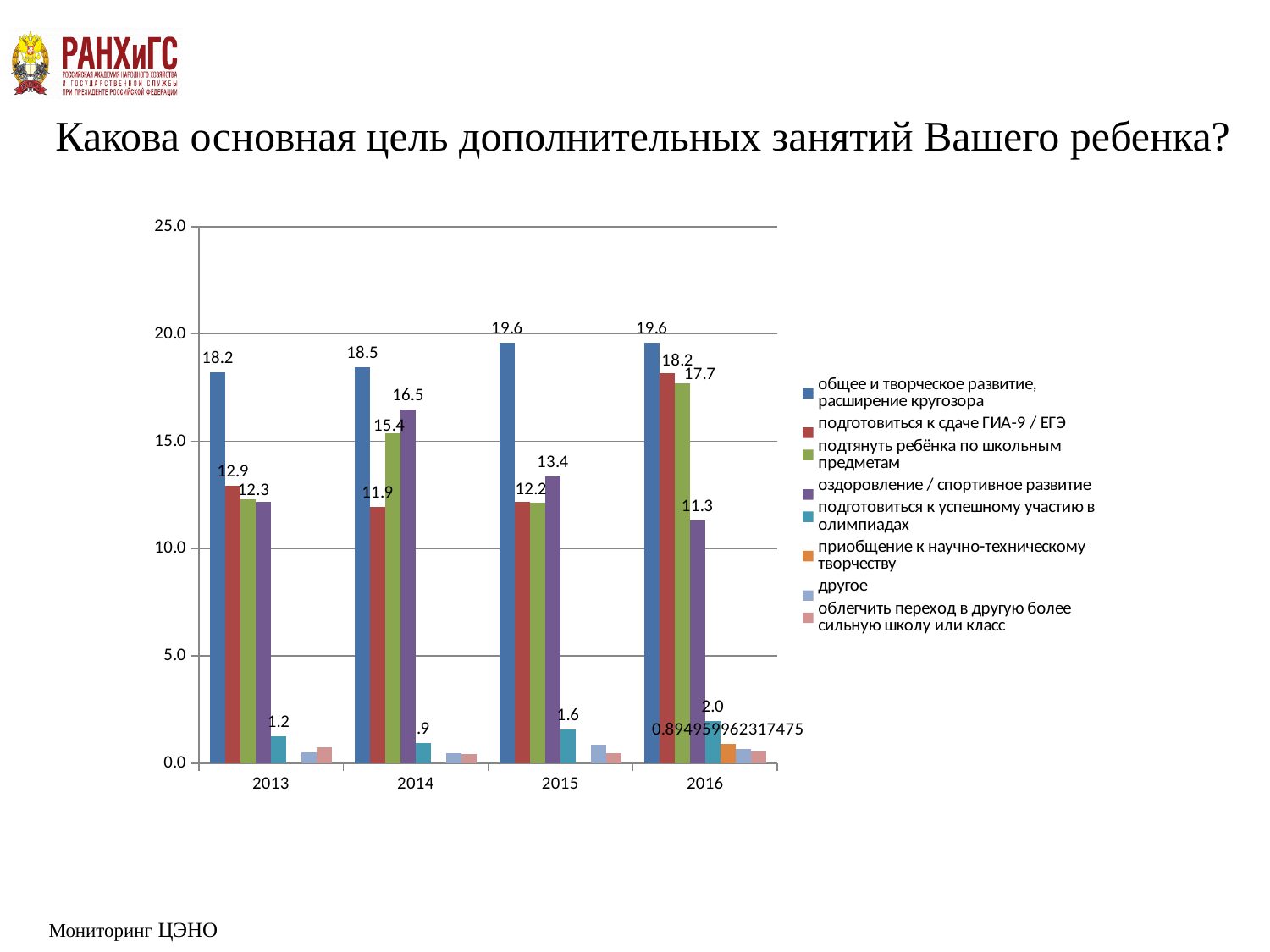
What is the value for 'общее и творческое развитие, расширение кругозора' in 2013? 18.2 Does the value for 'общее и творческое развитие, расширение кругозора' rise or fall from 2013 to 2016? rise What is the value for 'подготовиться к успешному участию в олимпиадах' in 2015? 1.6 How many years are shown along the x axis? 4 What is the value for 'оздоровление / спортивное развитие' in 2014? 16.5 What is the value for 'подтянуть ребёнка по школьным предметам' in 2016? 17.7 Is the value for 'оздоровление / спортивное развитие' in 2013 greater or less than 15.0? less Which series has the highest value in 2014? общее и творческое развитие, расширение кругозора What kind of chart is shown on the slide? bar chart In 2014, which is larger: 'подтянуть ребёнка по школьным предметам' or 'оздоровление / спортивное развитие'? оздоровление / спортивное развитие How many series does the legend list? 8 What is the difference between 'общее и творческое развитие, расширение кругозора' and 'подготовиться к сдаче ГИА-9 / ЕГЭ' in 2016? 1.4